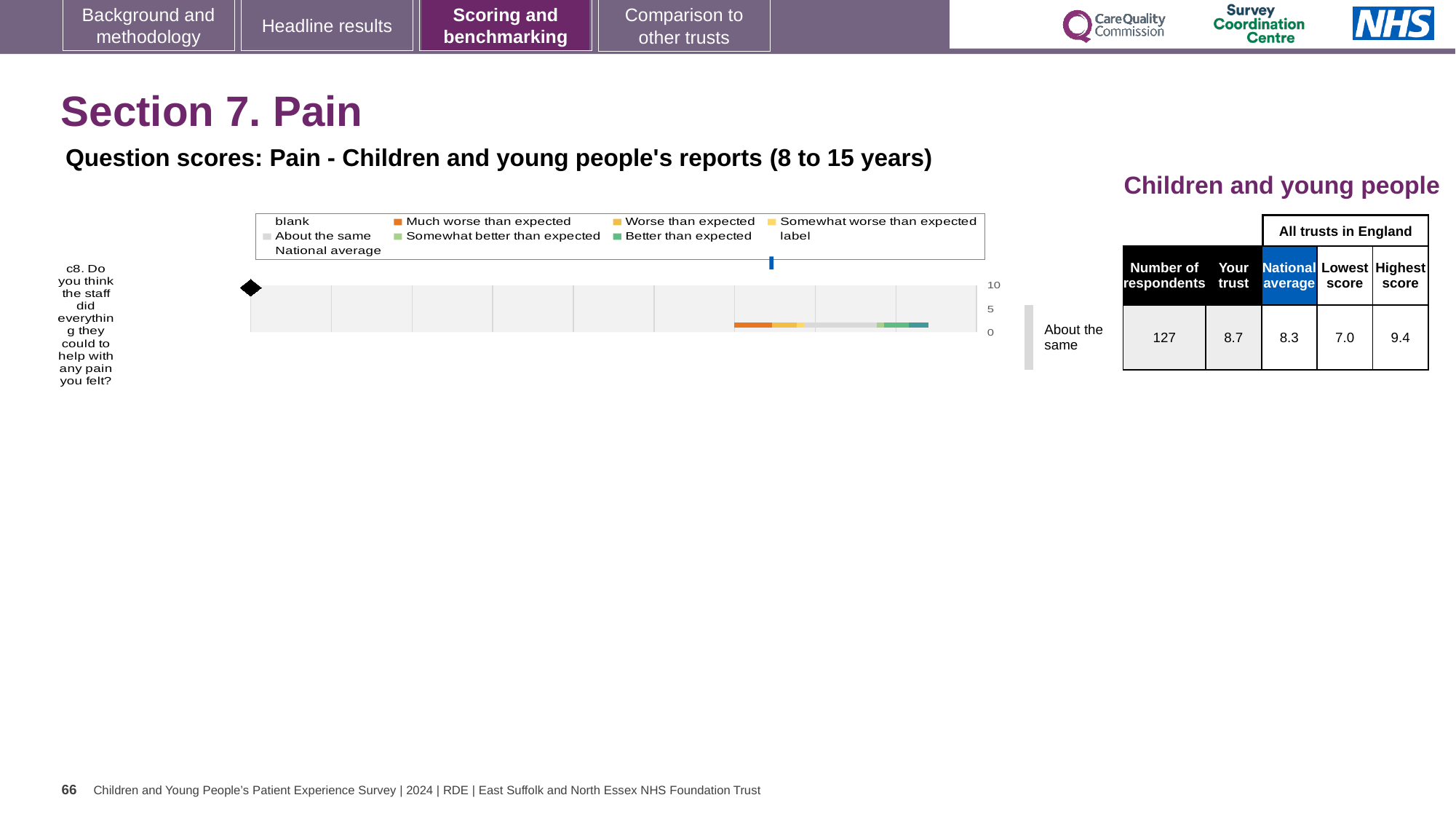
How many survey questions are plotted in the chart? 1 What is the difference between the 'Your trust' score and the national average for question c8? 0.4 What is the highest score among all trusts in England for question c8? 9.4 How many respondents answered question c8? 127 Which is higher for question c8: the 'Your trust' score or the national average? Your trust What is the national average score for question c8? 8.3 What is the difference between the highest score and the lowest score for question c8? 2.4 What kind of chart is shown on the slide? bar chart What is the lowest score among all trusts in England for question c8? 7.0 What is the 'Your trust' score for question c8 in the table beside the chart? 8.7 In the chart legend, what does the orange colour represent? Much worse than expected What benchmark rating is shown next to the chart for question c8? About the same